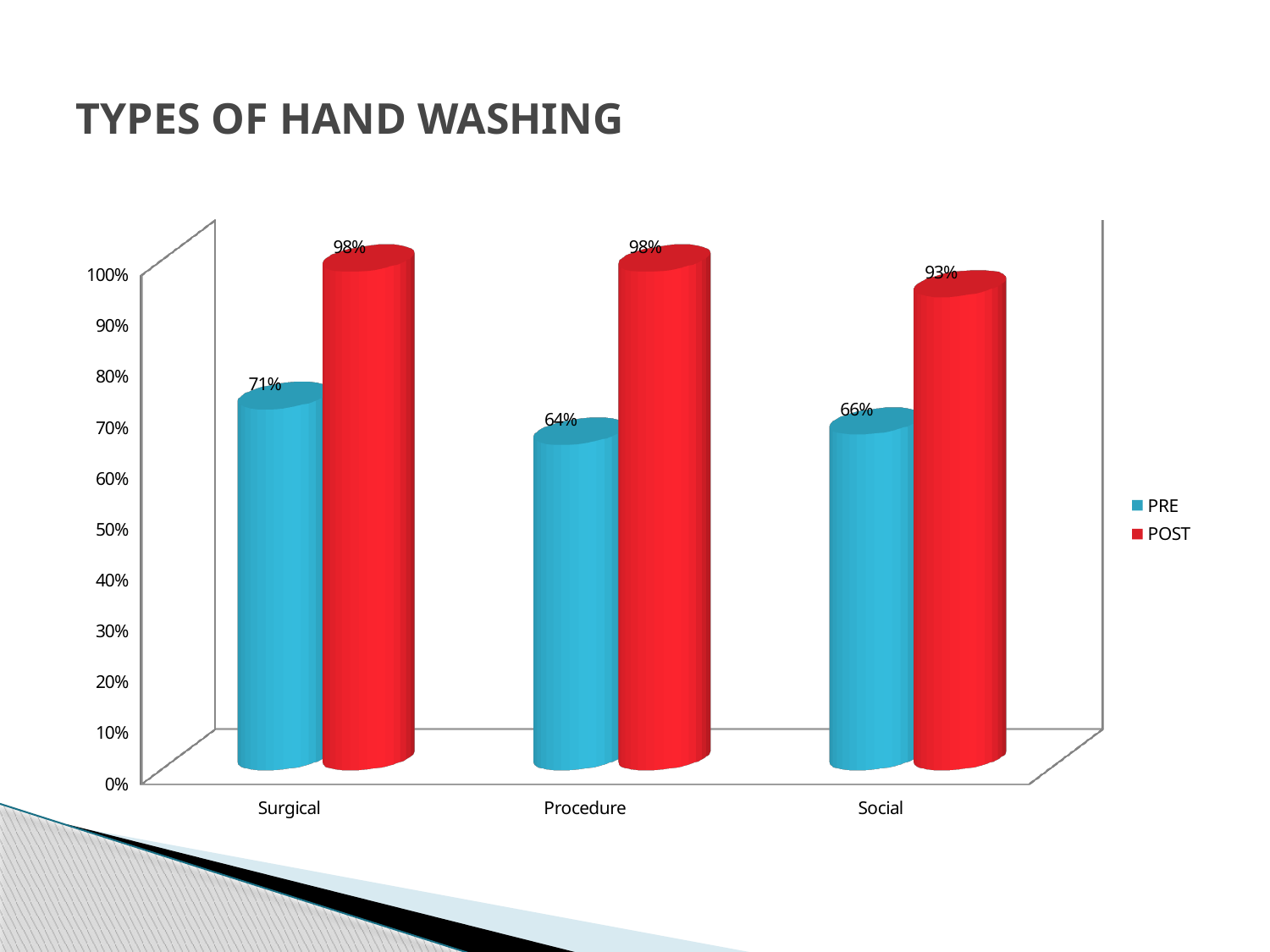
What kind of chart is shown on the slide? Bar chart Which is larger, the PRE value for Social or the PRE value for Procedure? Social What is the difference between the PRE values for Surgical and Social? 5% Which category has the lowest PRE value? Procedure What is the PRE value for Procedure hand washing? 64% What is the POST value for Social hand washing? 93% What is the difference between the POST and PRE values for Procedure? 34% How many series does the legend list? 2 Which category has the highest PRE value? Surgical How many categories are shown on the x axis? 3 Which category has the lowest POST value? Social What is the PRE value for Surgical hand washing? 71%